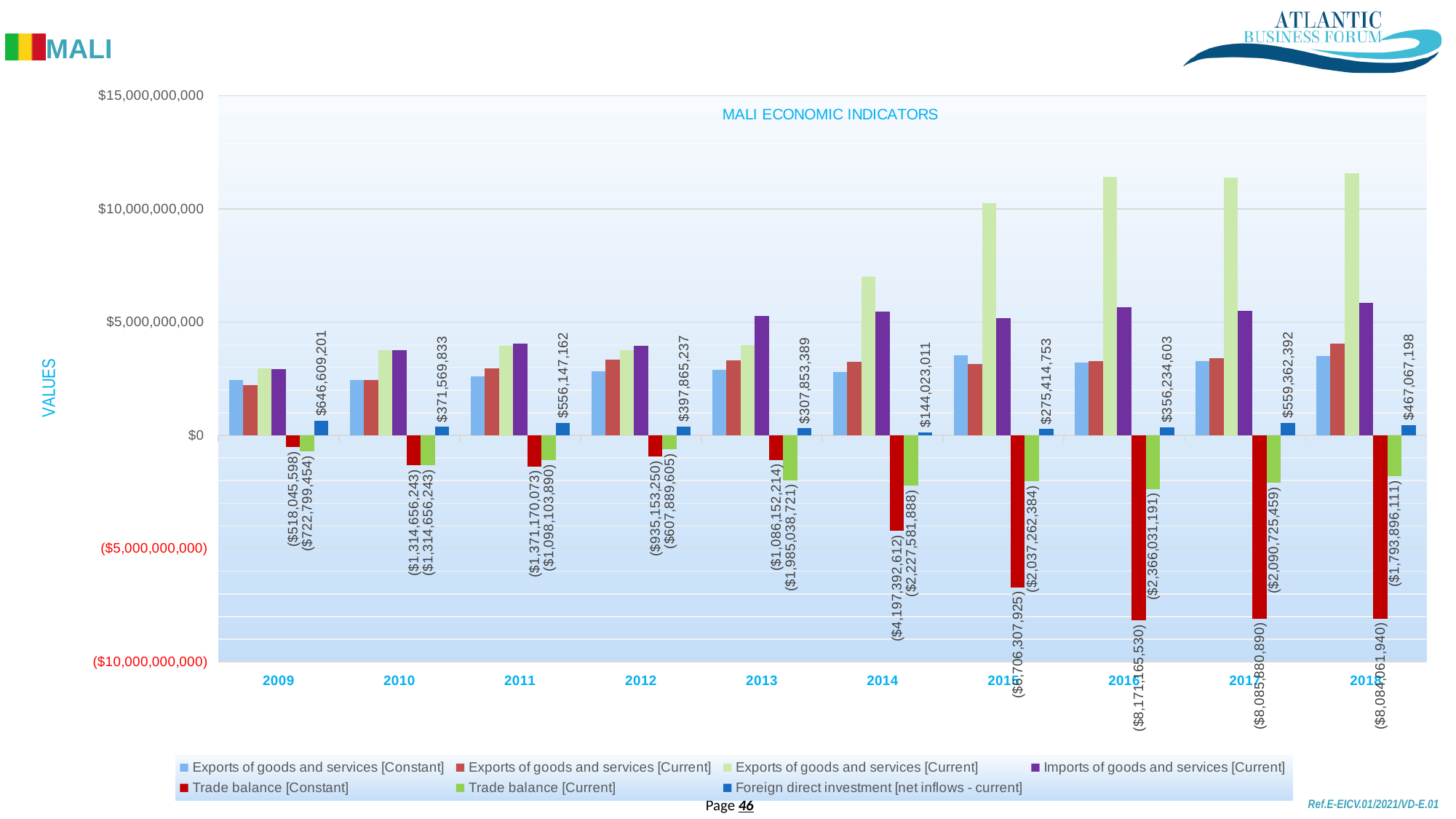
Which is larger, Foreign direct investment in 2009 or in 2018? 2009 What type of chart is shown on the slide? Bar chart What is the title of the chart? MALI ECONOMIC INDICATORS In which year is Foreign direct investment [net inflows - current] highest? 2009 How many years are shown on the x axis? 10 What is the value of Foreign direct investment [net inflows - current] in 2009? $646,609,201 How many series does the legend list? 7 What is the value of Trade balance [Current] in 2013? ($1,985,038,721) Is the value of Exports of goods and services [Current] (light green) in 2016 greater or less than $10,000,000,000? greater What is the difference between Foreign direct investment in 2009 and in 2010? $275,039,368 What is the value of Trade balance [Constant] in 2016? ($8,171,165,530) In which year is Foreign direct investment [net inflows - current] lowest? 2014